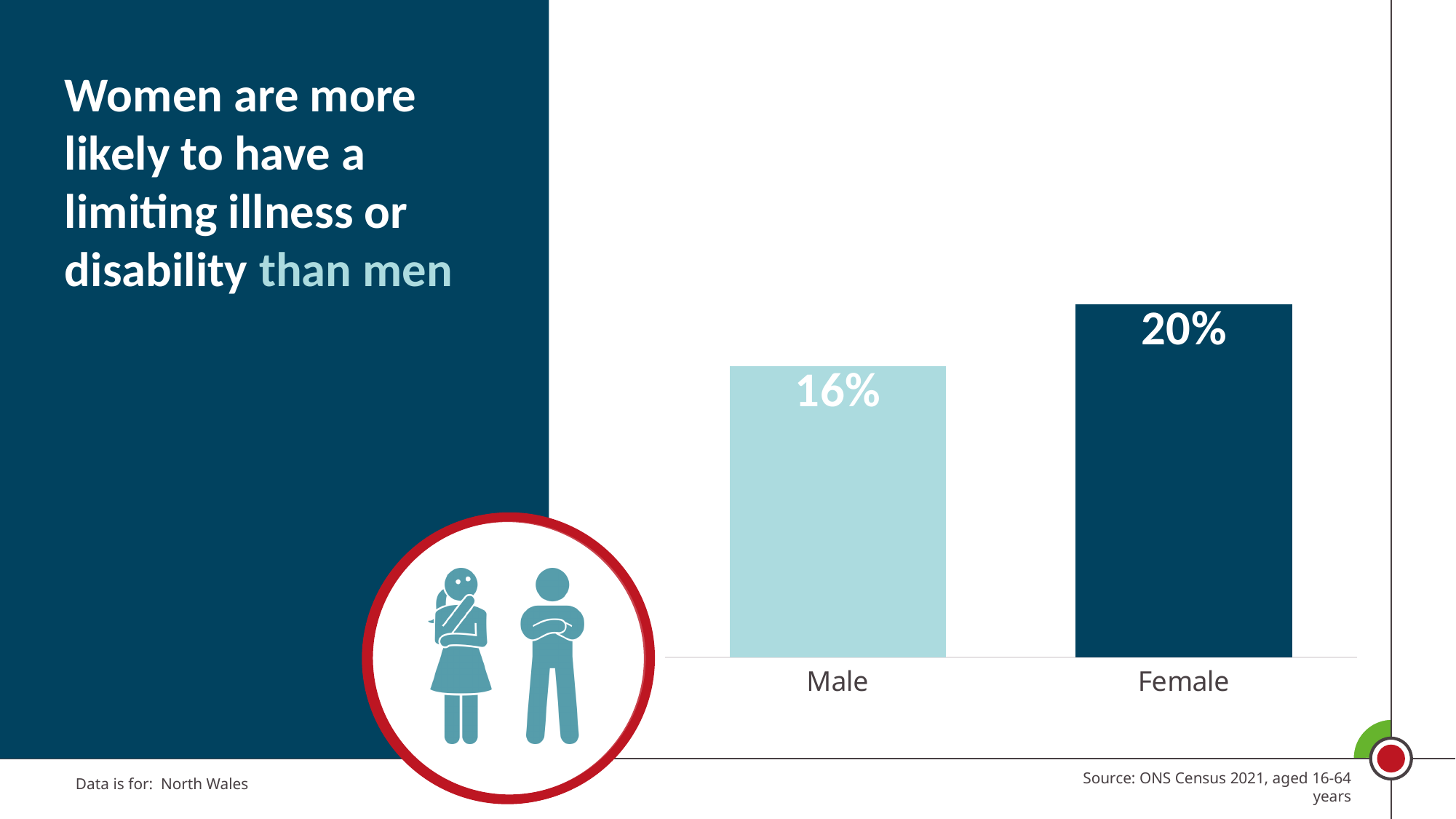
What is the difference between the Female and Male values? 4% What colour is the Female bar? Dark blue Do the values rise or fall from Male to Female? Rise Which category has the highest value? Female What is the value for Male? 16% What is the value for Female? 20% What kind of chart is shown on the slide? Bar chart How many categories are shown in the chart? 2 Which category has the lowest value? Male What source is cited for the chart data? ONS Census 2021, aged 16-64 years Which is larger, the value for Male or the value for Female? Female